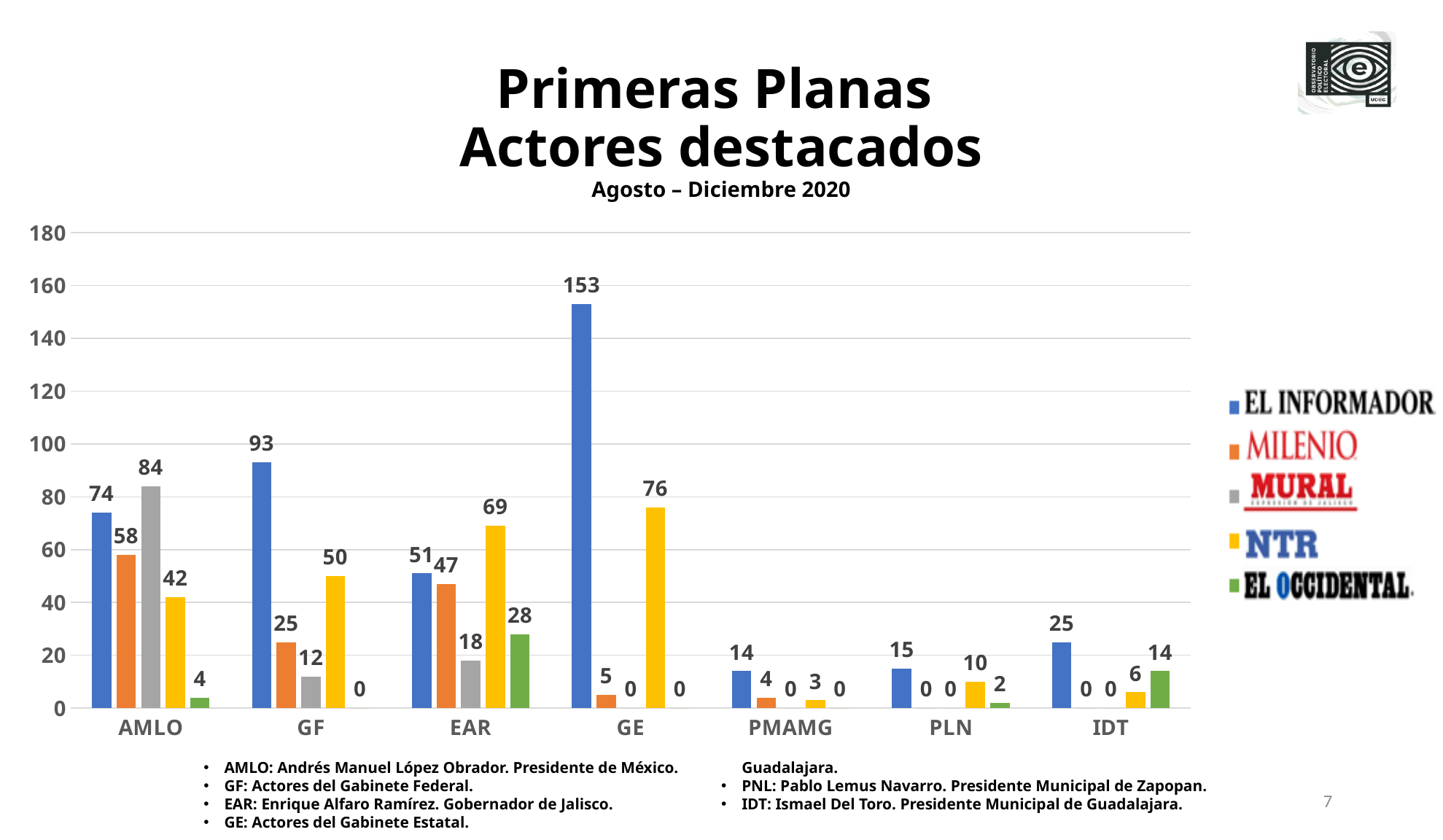
Which category has the lowest NTR value? PMAMG What is the value for MURAL in the AMLO category? 84 What kind of chart is shown on the slide? Bar chart Which category has the highest EL INFORMADOR value? GE In the AMLO category, which is larger: the EL INFORMADOR value or the MURAL value? MURAL What is the difference between the EL INFORMADOR value and the NTR value in the GE category? 77 What is the value for NTR in the EAR category? 69 How many categories are shown on the x axis? 7 What is the value for EL INFORMADOR in the GE category? 153 What is the value for EL OCCIDENTAL in the IDT category? 14 How many series does the legend list? 5 What is the total of the MILENIO values for AMLO and GF combined? 83